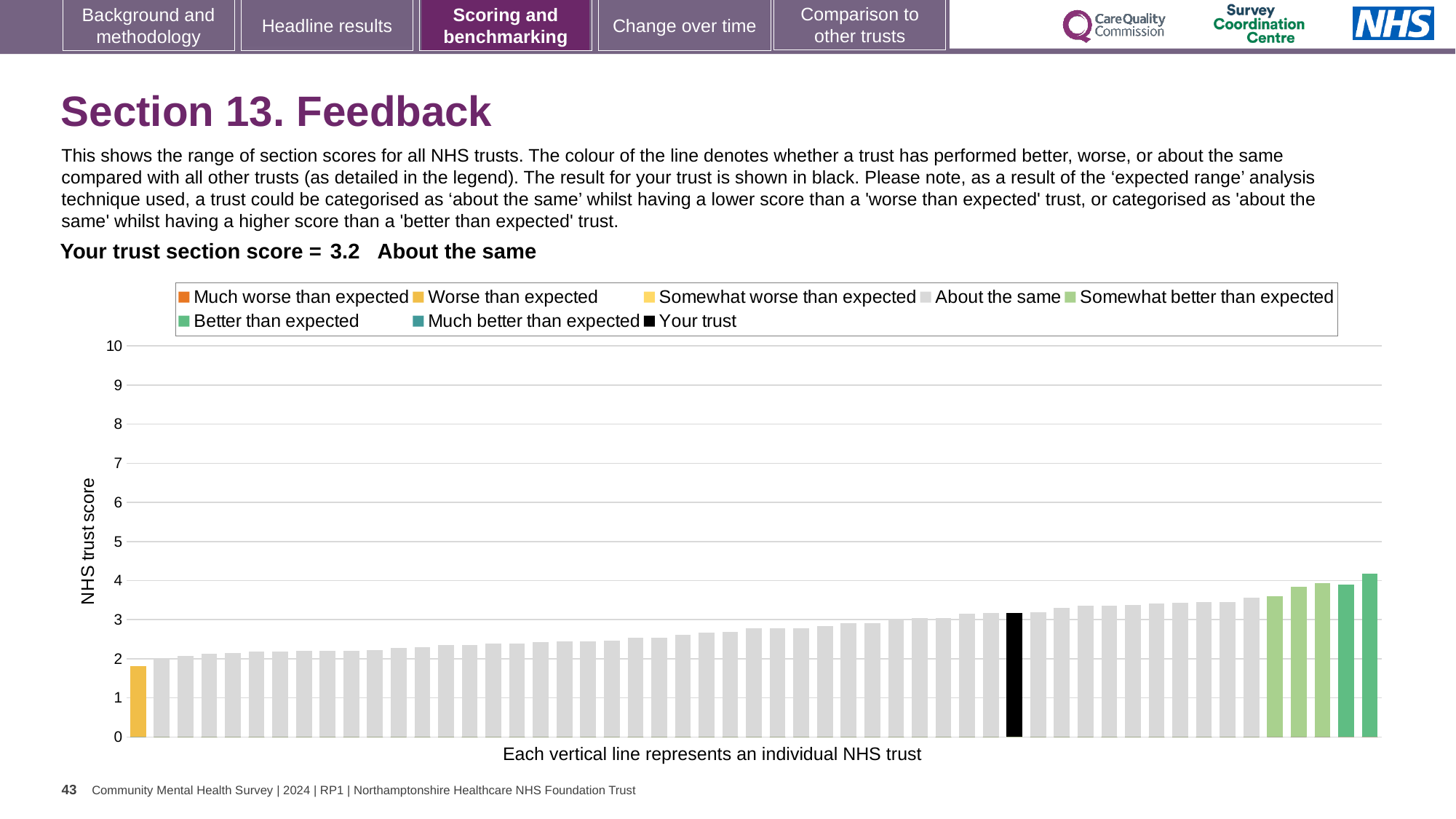
What is the label on the vertical axis of the chart? NHS trust score Which performance category is your trust placed in for Section 13? About the same How many bars are coloured as 'Worse than expected' (yellow)? 1 Do the bar values rise or fall moving from left to right along the x axis? rise Is the value of the tallest bar in the chart greater or less than 4? greater Is the value of the shortest bar in the chart greater or less than 2? less How many bars are coloured as 'Better than expected' (dark green)? 2 Is the value for your trust (the black bar) greater or less than 4? less How many entries does the chart legend list? 8 What type of chart is shown on the slide? bar chart What is the section score for your trust shown on the slide? 3.2